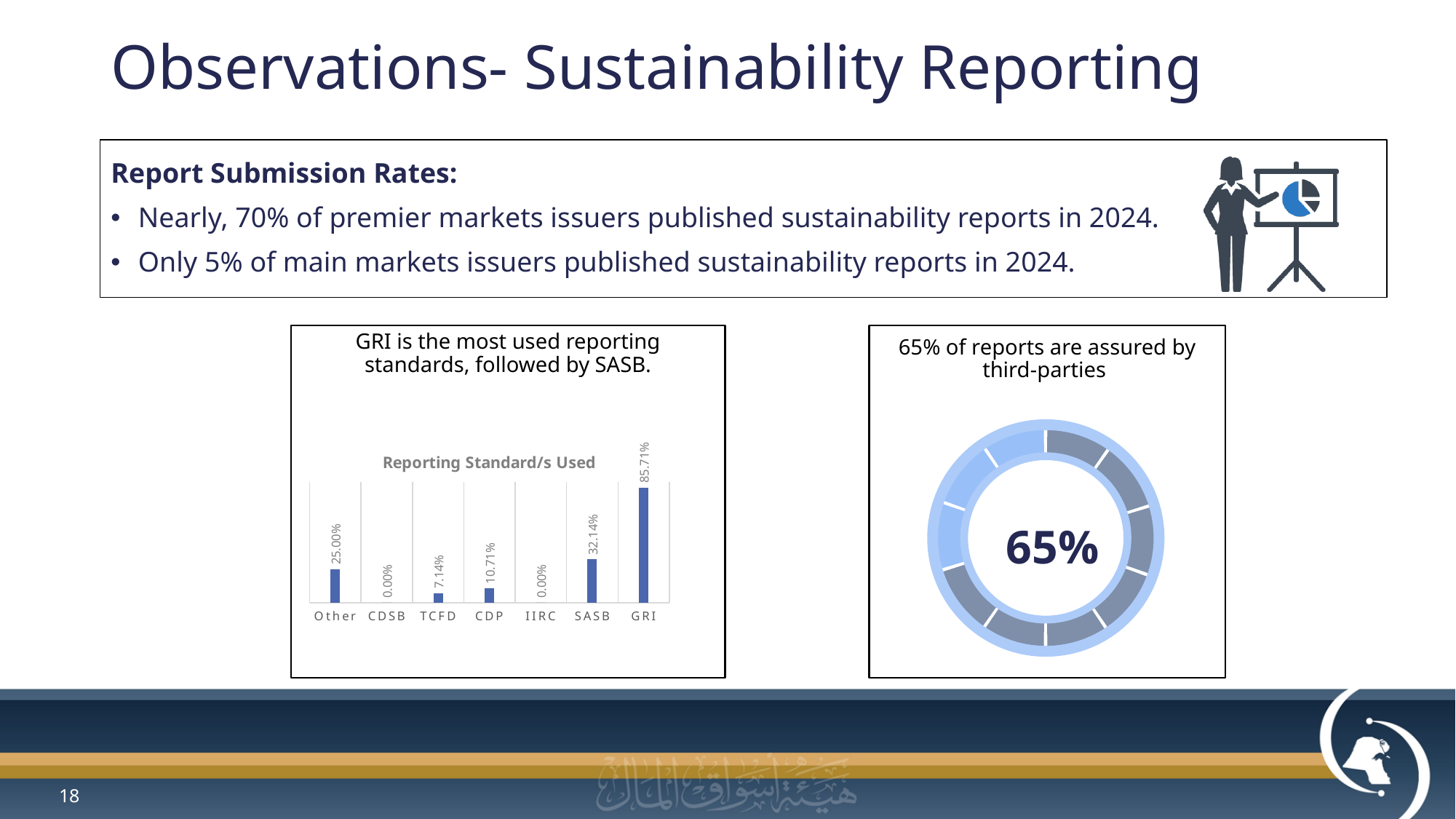
In the donut chart on the right of the slide, what percentage of reports are assured by third-parties? 65% In the 'Reporting Standard/s Used' bar chart, what is the value for SASB? 32.14% In the 'Reporting Standard/s Used' bar chart, which is larger, the value for Other or the value for CDP? Other In the 'Reporting Standard/s Used' bar chart, what is the value for Other? 25.00% How many categories are shown in the 'Reporting Standard/s Used' bar chart? 7 In the 'Reporting Standard/s Used' bar chart, what is the difference between the values for GRI and SASB? 53.57% In the 'Reporting Standard/s Used' bar chart, what is the value for CDP? 10.71% In the 'Reporting Standard/s Used' bar chart, what is the value for GRI? 85.71% In the 'Reporting Standard/s Used' bar chart, which reporting standard has the highest value? GRI What kind of chart is the 'Reporting Standard/s Used' chart? Bar chart In the 'Reporting Standard/s Used' bar chart, which two categories have a value of 0.00%? CDSB and IIRC In the 'Reporting Standard/s Used' bar chart, what is the value for TCFD? 7.14%